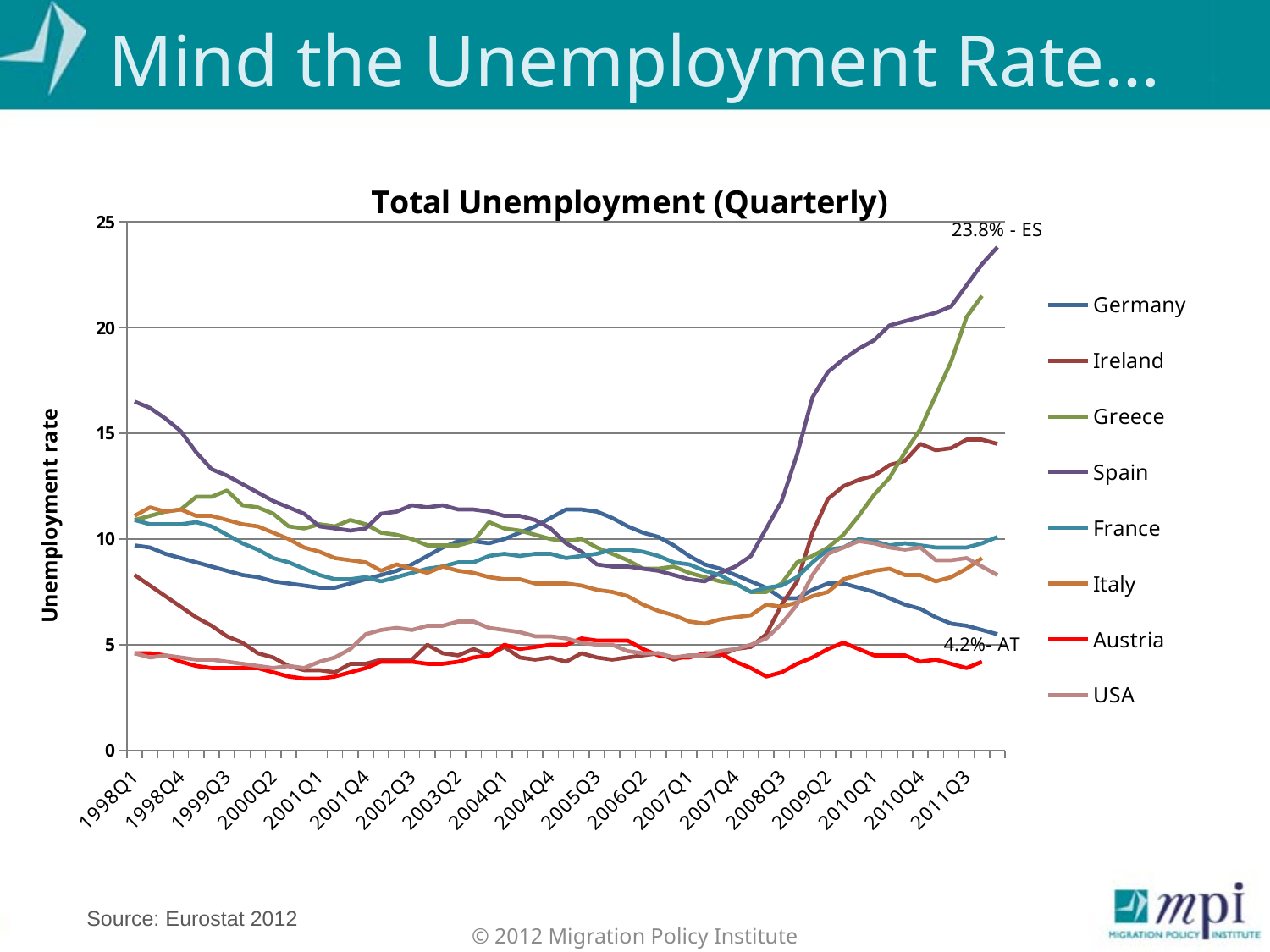
What is the labelled final value for Spain (ES)? 23.8% Is the value for Spain at 1998Q1 greater or less than 15? greater What is the labelled final value for Austria (AT)? 4.2% Is the value for Greece at 2011Q3 greater or less than 15? greater What is the title of the chart? Total Unemployment (Quarterly) What kind of chart is shown on the slide? line chart At 2011Q3, which is larger, the value for Ireland or the value for Austria? Ireland Which country has the highest unemployment rate at the end of the series? Spain Which country has the lowest unemployment rate at the end of the series? Austria What is the difference between the labelled final values for Spain and Austria? 19.6% Does the unemployment rate for Spain rise or fall from 2008Q3 to the end of the series? rise How many series does the legend list? 8